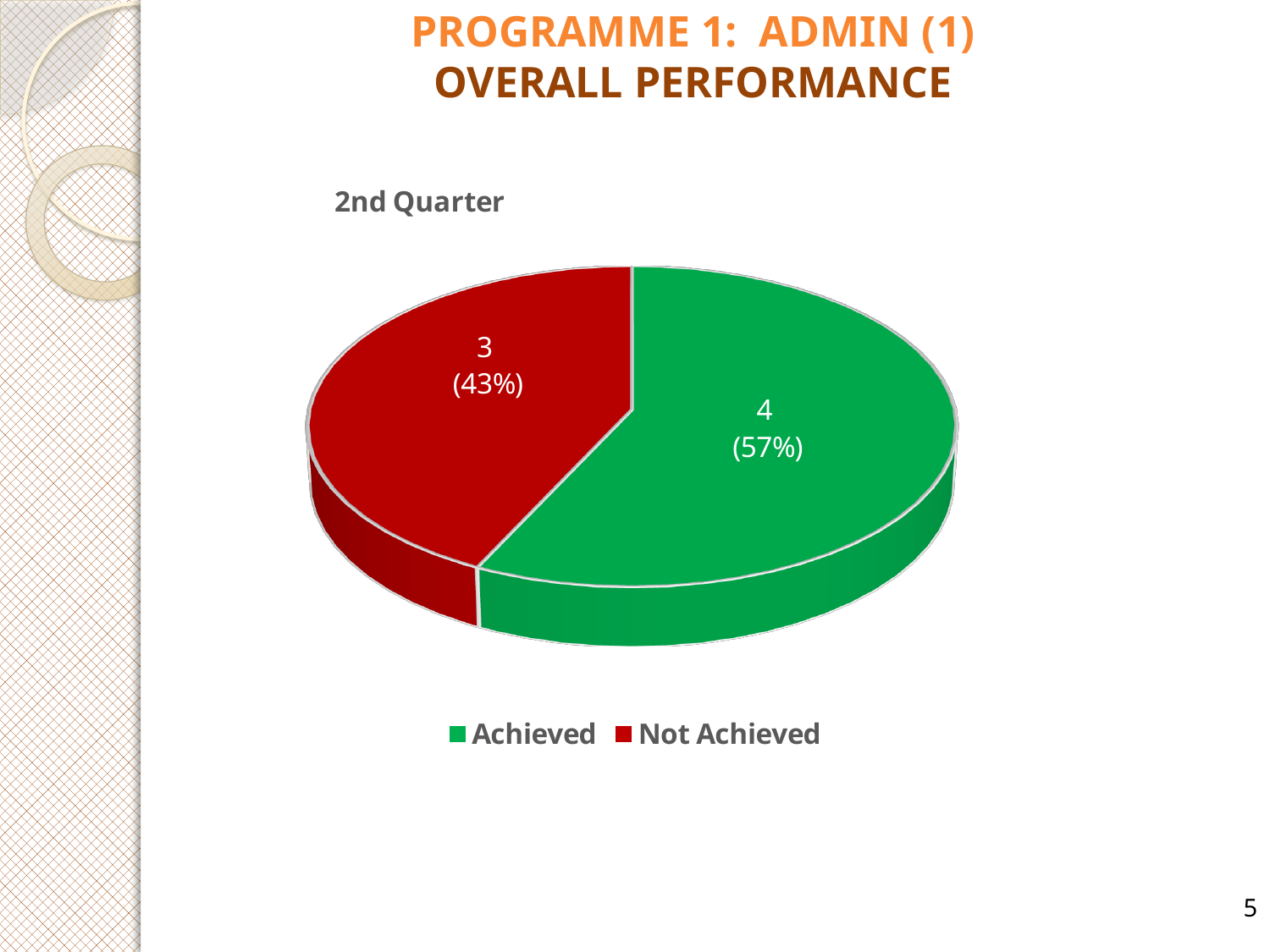
What is the chart's title? 2nd Quarter Which slice is the smallest? Not Achieved What share of the pie is Not Achieved? 43% What is the value for Not Achieved? 3 What is the difference between the Achieved and Not Achieved values? 1 What colour is the Not Achieved slice? Red How many slices does the pie chart have? 2 What share of the pie is Achieved? 57% What is the value for Achieved? 4 How many entries does the legend list? 2 What kind of chart is shown on the slide? Pie chart Which slice is the largest? Achieved